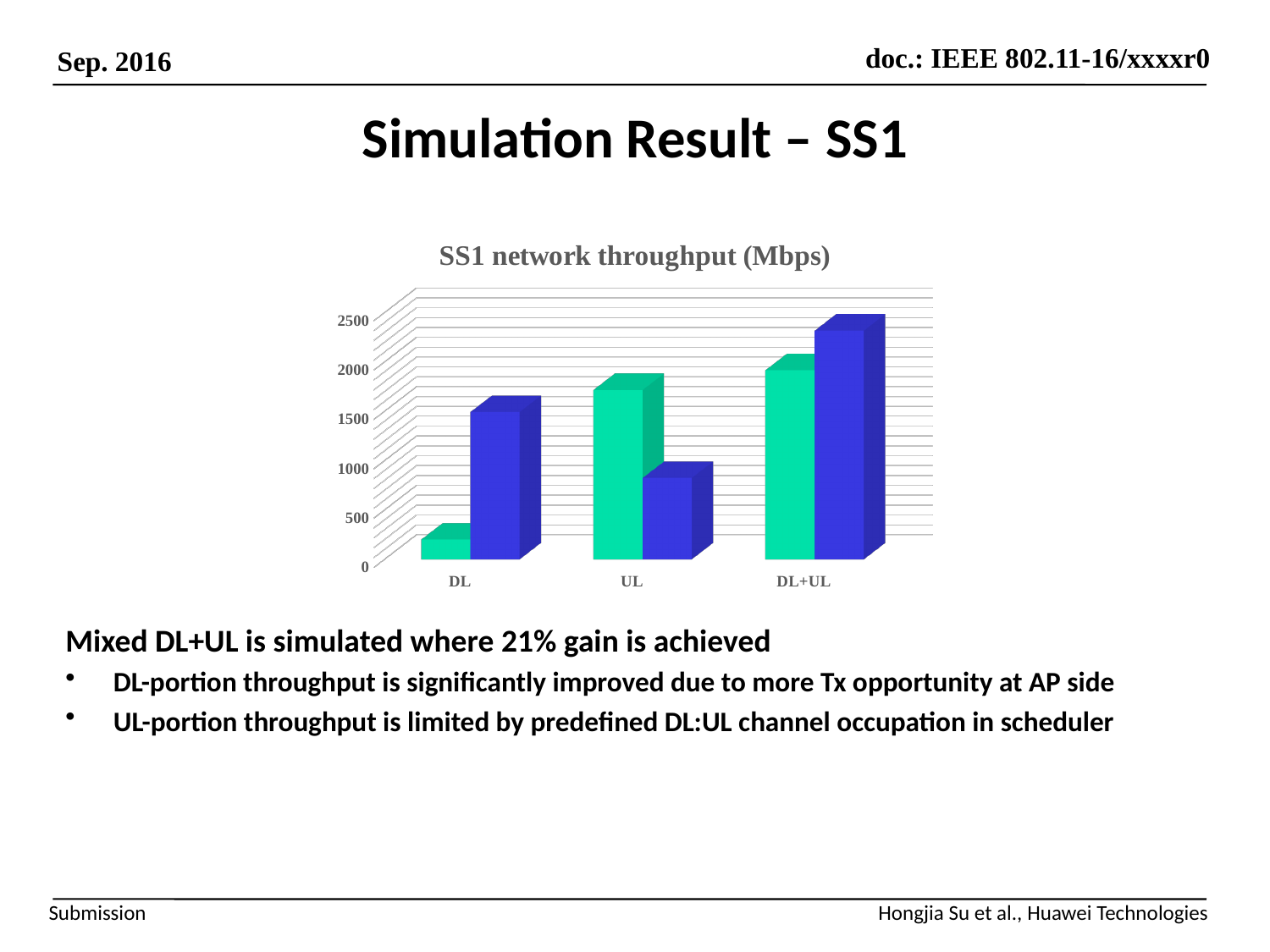
Is the value of the blue bar for DL+UL greater or less than 2000? greater For the UL category, which bar is larger, the green one or the blue one? green How many categories are shown on the x axis of the chart? 3 Is the value of the blue bar for UL greater or less than 1000? less What kind of chart is shown on the slide? bar chart For the DL category, which bar is larger, the green one or the blue one? blue Is the value of the blue bar for DL greater or less than 1000? greater Which category has the lowest blue bar? UL Which category has the highest green bar? DL+UL What is the title of the chart? SS1 network throughput (Mbps)